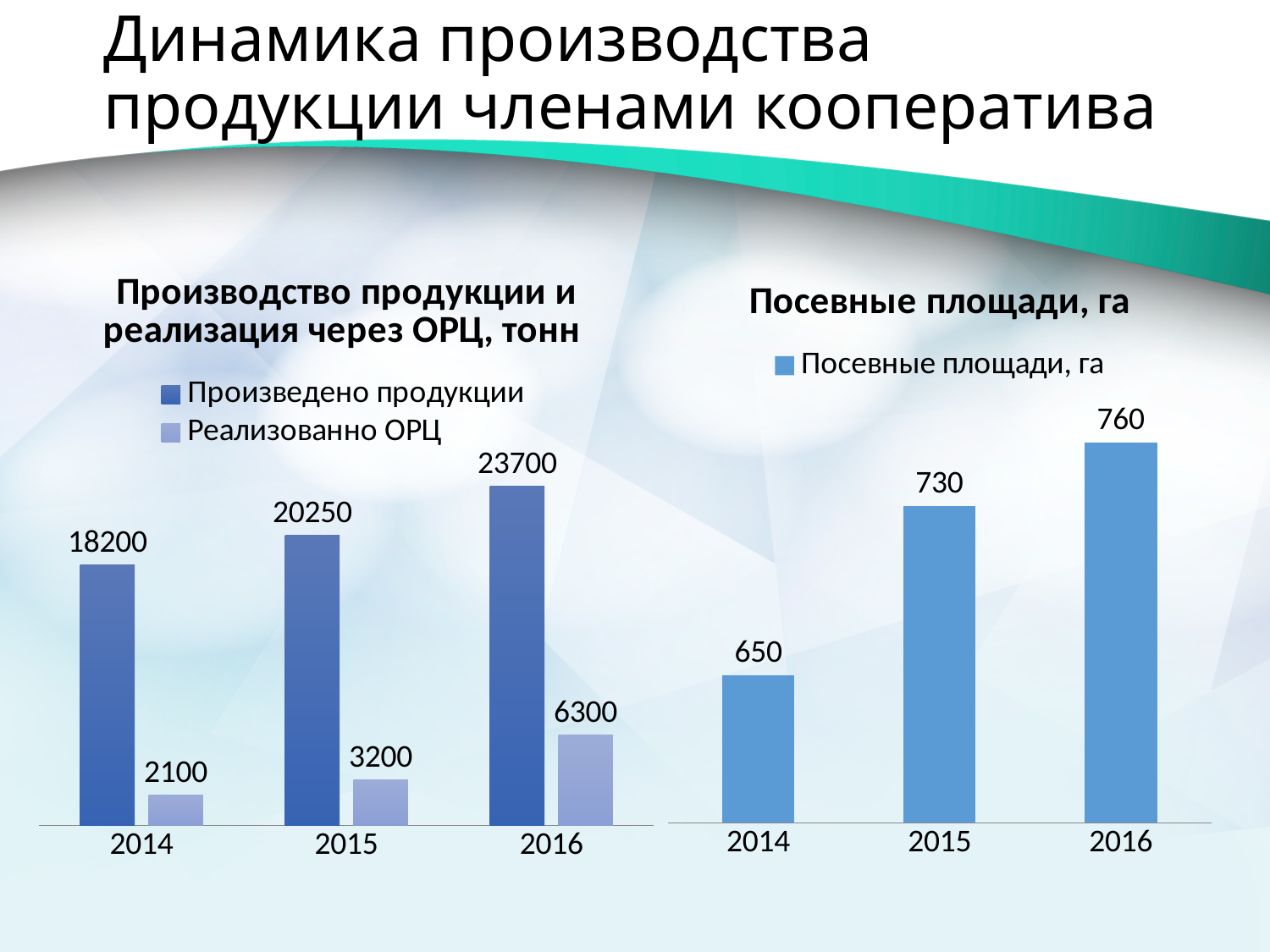
In the right chart 'Посевные площади, га', which is larger: the value for 2015 or the value for 2016? 2016 In the left chart 'Производство продукции и реализация через ОРЦ, тонн', what is the difference between 'Произведено продукции' and 'Реализованно ОРЦ' in 2014? 16100 In the left chart 'Производство продукции и реализация через ОРЦ, тонн', do the values of 'Произведено продукции' rise or fall from 2014 to 2016? Rise In the left chart 'Производство продукции и реализация через ОРЦ, тонн', what is the value of 'Реализованно ОРЦ' for 2016? 6300 In the left chart 'Производство продукции и реализация через ОРЦ, тонн', which year has the lowest value of 'Реализованно ОРЦ'? 2014 What kind of chart is the right chart 'Посевные площади, га'? Bar chart In the left chart 'Производство продукции и реализация через ОРЦ, тонн', what is the value of 'Произведено продукции' for 2015? 20250 In the left chart 'Производство продукции и реализация через ОРЦ, тонн', which year has the highest value of 'Произведено продукции'? 2016 In the right chart 'Посевные площади, га', what is the difference between the values for 2016 and 2014? 110 How many series does the legend of the left chart 'Производство продукции и реализация через ОРЦ, тонн' list? 2 In the right chart 'Посевные площади, га', what is the value for 2014? 650 How many years are shown on the x axis of the right chart 'Посевные площади, га'? 3